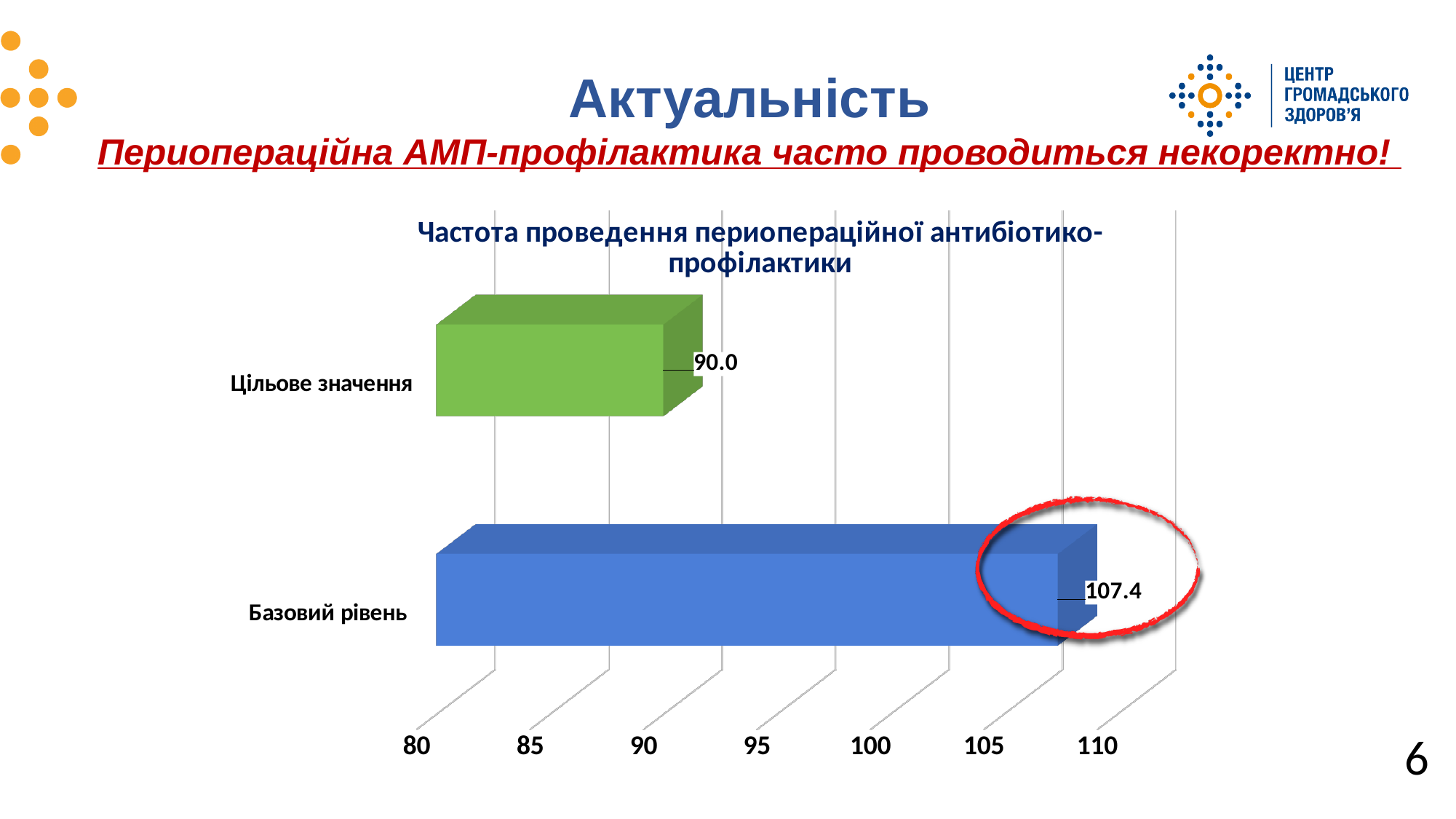
What is the value for Цільове значення? 90.0 How many categories are shown in the chart? 2 What kind of chart is shown on the slide? bar chart Which category has the highest value? Базовий рівень What is the value for Базовий рівень? 107.4 What colour is the bar for Цільове значення? green Which is larger, the value for Базовий рівень or the value for Цільове значення? Базовий рівень What is the difference between the values for Базовий рівень and Цільове значення? 17.4 Is the value for Базовий рівень greater or less than 100? greater What is the title of the chart? Частота проведення периопераційної антибіотико-профілактики Which category has the lowest value? Цільове значення Is the value for Цільове значення greater or less than 95? less